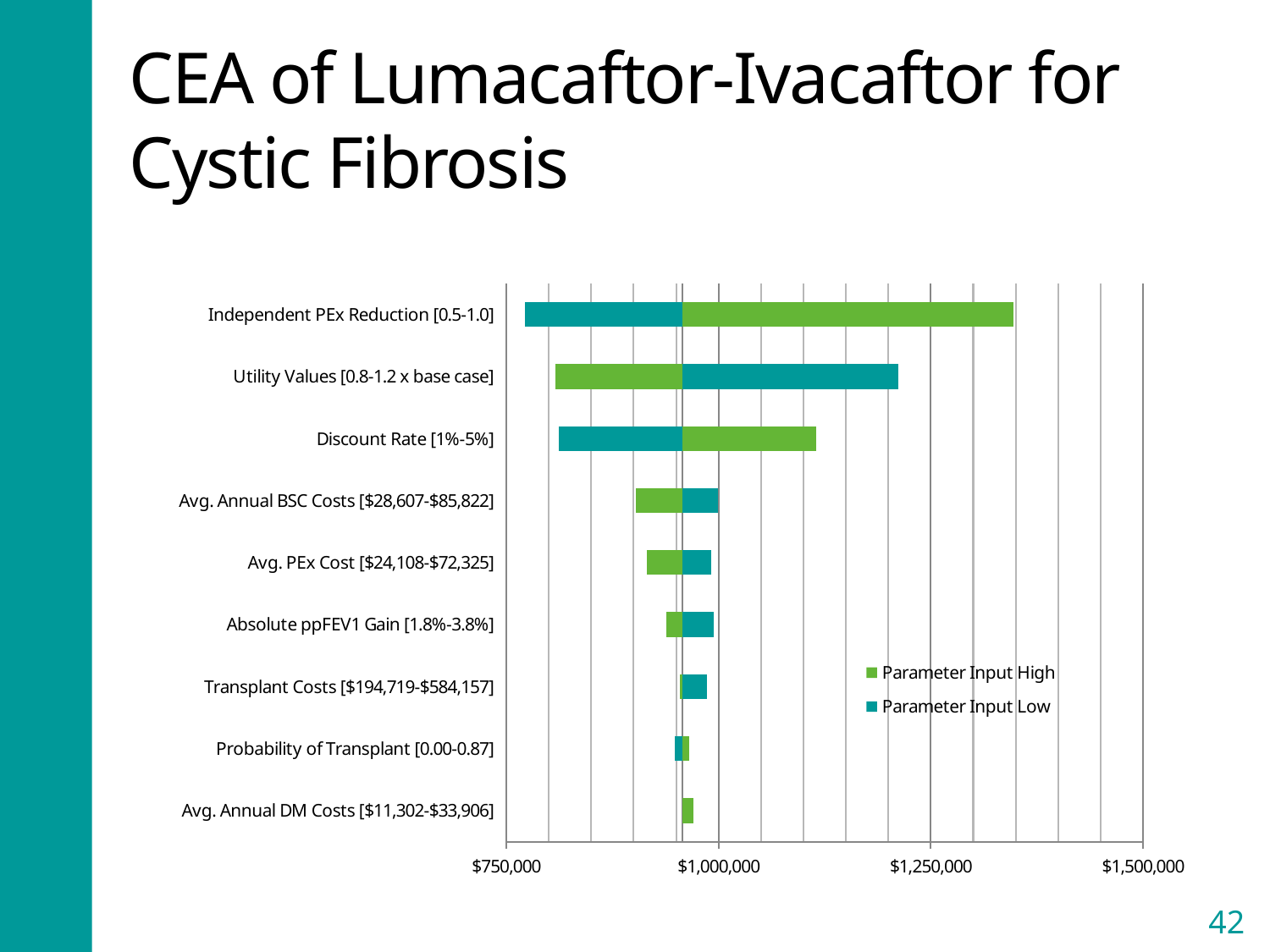
Is the right end of the bar for Avg. PEx Cost [$24,108-$72,325] greater or less than $1,000,000? less Which parameter has the widest overall bar (largest range) in the chart? Independent PEx Reduction [0.5-1.0] How many series does the chart legend list? 2 What are the two series named in the chart legend? Parameter Input High and Parameter Input Low Is the right end of the bar for Utility Values [0.8-1.2 x base case] greater or less than $1,250,000? less Which parameter is listed at the bottom of the chart's vertical axis? Avg. Annual DM Costs [$11,302-$33,906] What kind of chart is shown on the slide? Bar chart How many parameters (categories) are listed on the vertical axis of the chart? 9 Which bar extends further to the right: Independent PEx Reduction [0.5-1.0] or Discount Rate [1%-5%]? Independent PEx Reduction [0.5-1.0] Is the right end of the bar for Discount Rate [1%-5%] greater or less than $1,000,000? greater Which colour represents Parameter Input High in the chart? Green